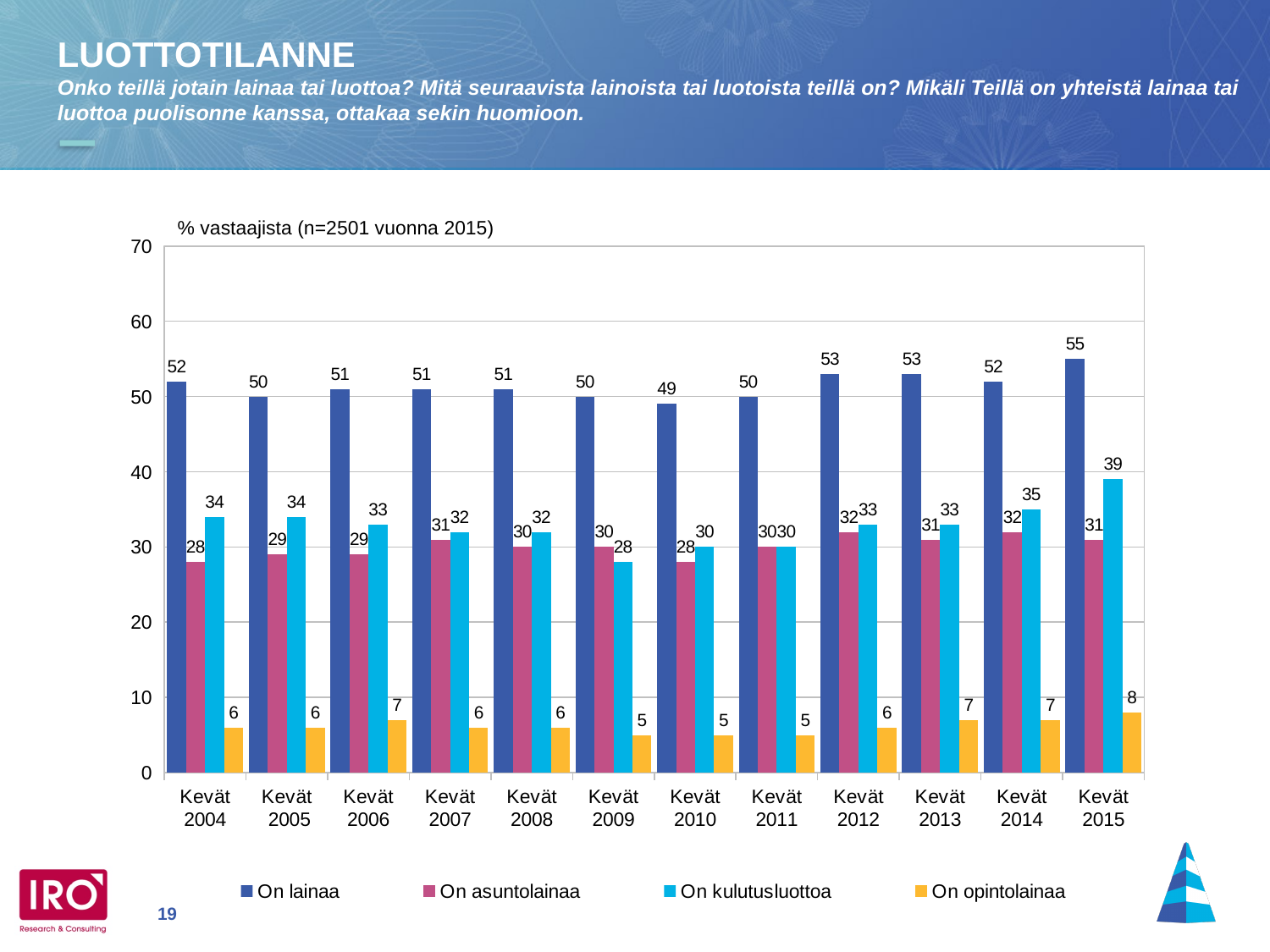
What is the value for 'On lainaa' in Kevät 2015? 55 What is the value for 'On opintolainaa' in Kevät 2006? 7 How many series does the legend list? 4 What is the difference between the 'On kulutusluottoa' values in Kevät 2015 and Kevät 2014? 4 In which period is the 'On lainaa' value highest? Kevät 2015 What is the value for 'On kulutusluottoa' in Kevät 2009? 28 Does the 'On opintolainaa' value rise or fall from Kevät 2011 to Kevät 2015? rise How many time periods (categories) are shown on the x axis? 12 What type of chart is shown on the slide? bar chart In which period is the 'On lainaa' value lowest? Kevät 2010 In Kevät 2009, which is larger: 'On asuntolainaa' or 'On kulutusluottoa'? On asuntolainaa What colour represents the 'On opintolainaa' series? yellow